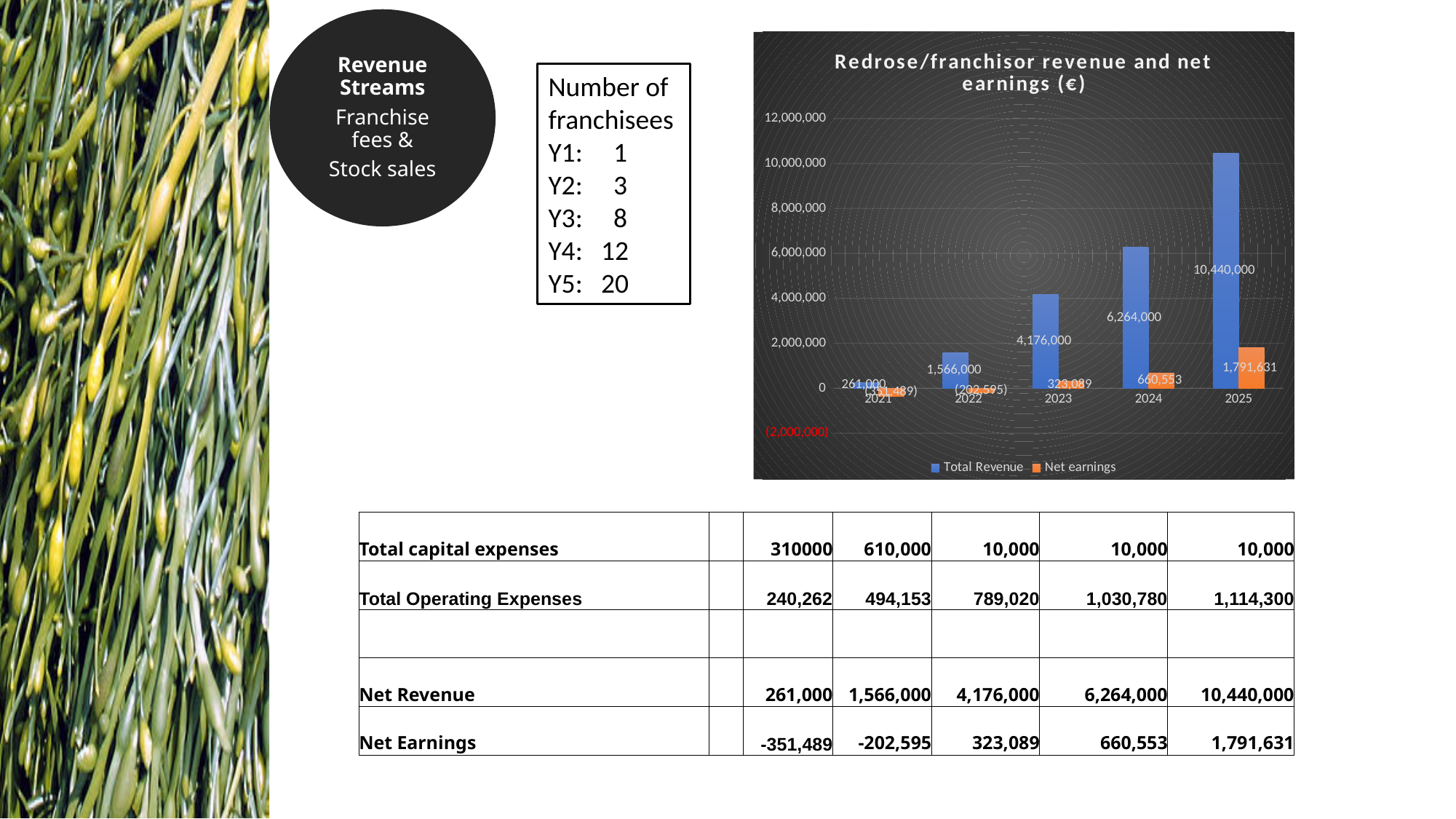
How many years are shown on the x axis of the chart? 5 What is the difference between Total Revenue in 2025 and 2024 in the chart? 4,176,000 What is the Net earnings value for 2025 in the chart? 1,791,631 Which year has the lowest Total Revenue in the chart? 2021 What is the Total Revenue for 2025 in the chart? 10,440,000 Does Total Revenue rise or fall from 2021 to 2025 in the chart? Rise What is the Total Revenue for 2023 in the chart? 4,176,000 Which year has the highest Total Revenue in the chart? 2025 How many series does the chart legend list? 2 What is the Net earnings value for 2024 in the chart? 660,553 What type of chart is shown on the slide? Bar chart What is the title of the chart? Redrose/franchisor revenue and net earnings (€)